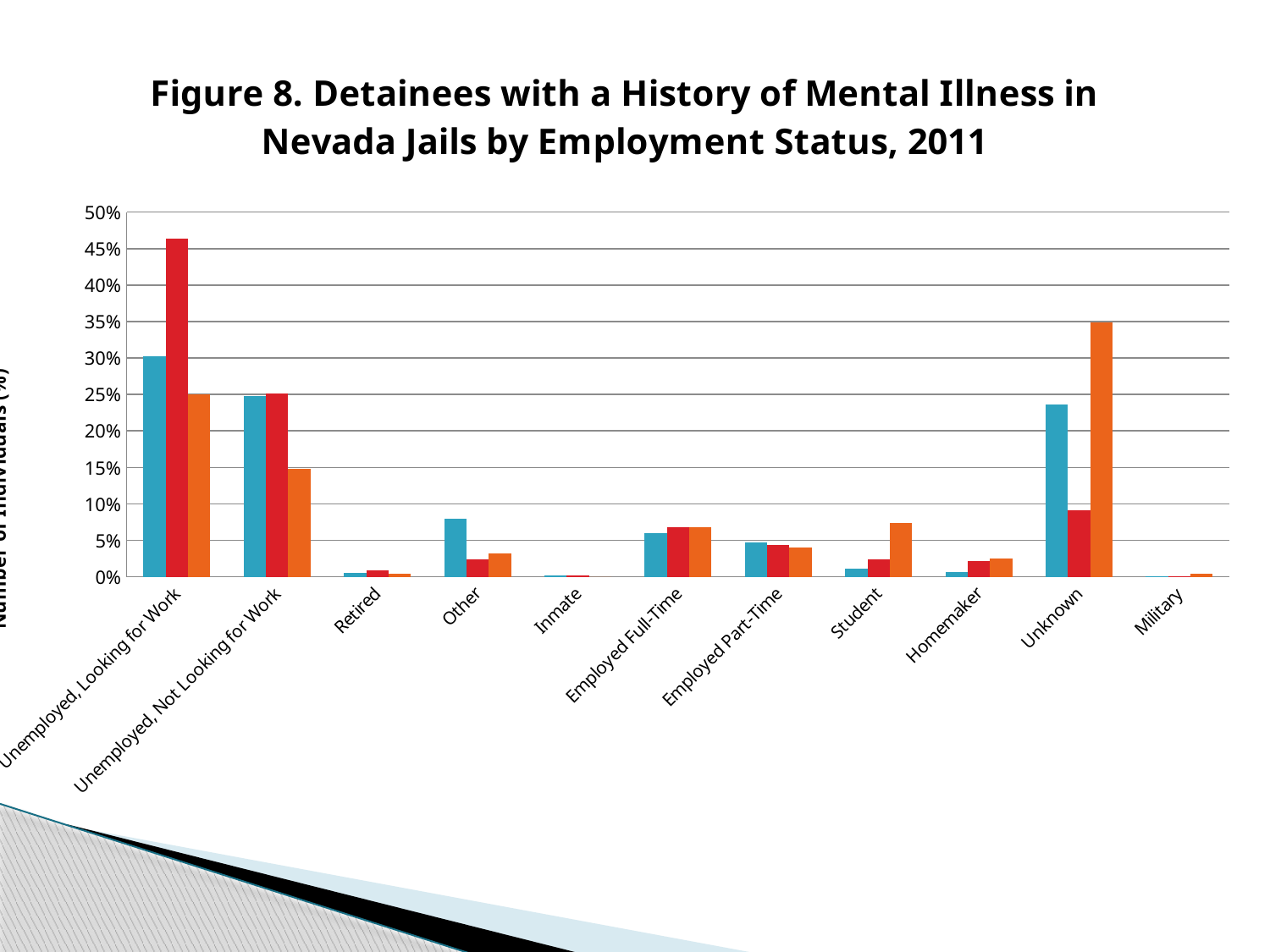
Which employment status category has the tallest blue bar? Unemployed, Looking for Work For the Student category, which is larger: the orange bar or the blue bar? the orange bar How many employment status categories are shown on the x axis? 11 Which employment status category has the tallest orange bar? Unknown How many differently coloured bars are plotted for each employment status category? 3 For the Other category, which is larger: the blue bar or the orange bar? the blue bar Which employment status category has the tallest red bar? Unemployed, Looking for Work Is the blue bar for Unknown greater or less than 25%? less Is the red bar for Unemployed, Looking for Work greater or less than 40%? greater Is the orange bar for Unknown greater or less than 30%? greater What is the title of the chart? Figure 8. Detainees with a History of Mental Illness in Nevada Jails by Employment Status, 2011 What kind of chart is shown on the slide? bar chart